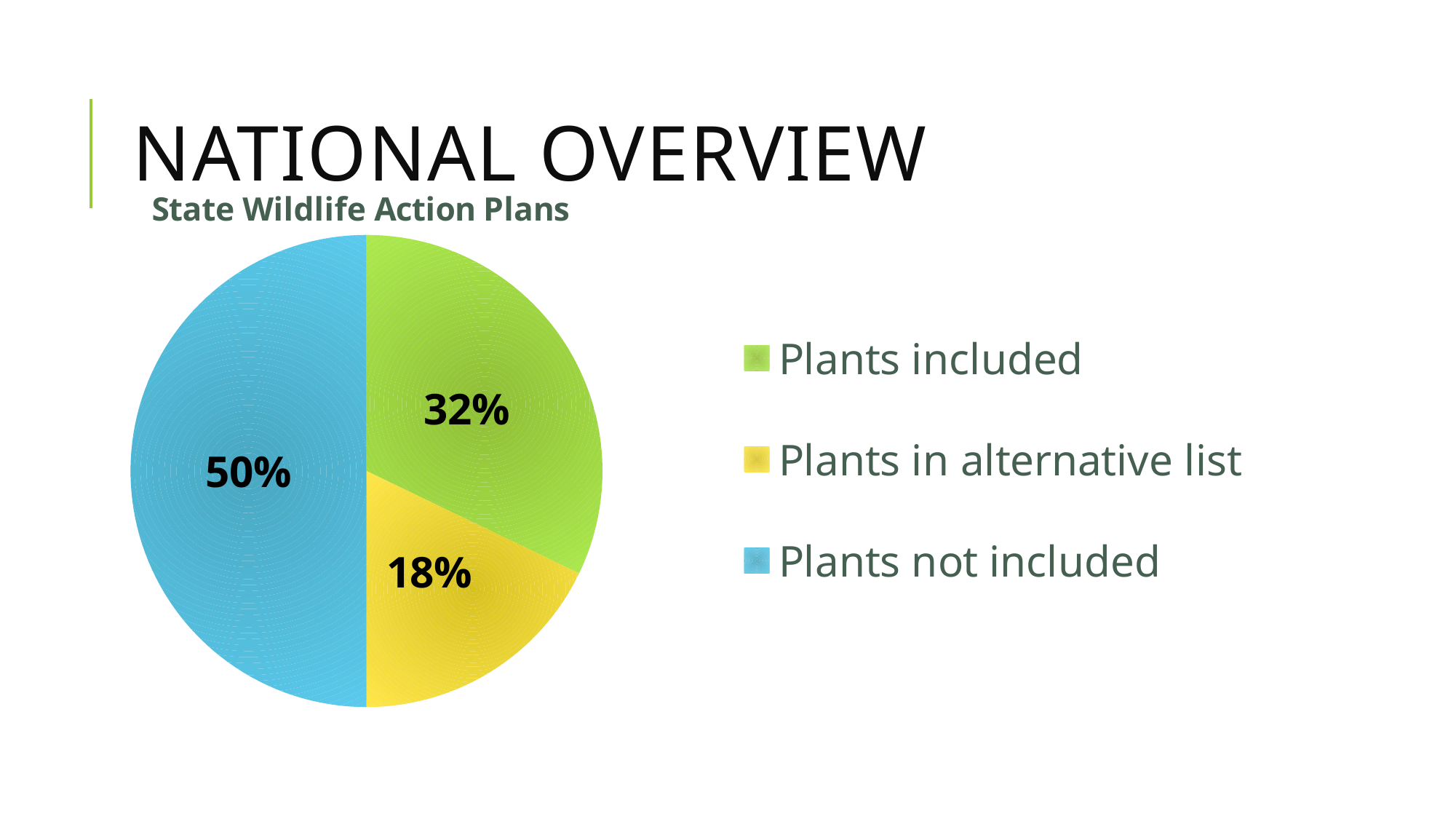
What share of the pie is labelled "Plants in alternative list"? 18% Which category has the smallest slice of the pie? Plants in alternative list Which is larger, the slice for "Plants included" or the slice for "Plants in alternative list"? Plants included How many entries does the legend list? 3 What colour is the slice for "Plants not included"? blue What share of the pie is labelled "Plants not included"? 50% What type of chart is shown on the slide? pie chart What is the difference in percentage points between "Plants not included" and "Plants included"? 18% What share of the pie is labelled "Plants included"? 32% Which category has the largest slice of the pie? Plants not included How many slices does the pie chart have? 3 What is the title of the chart? State Wildlife Action Plans